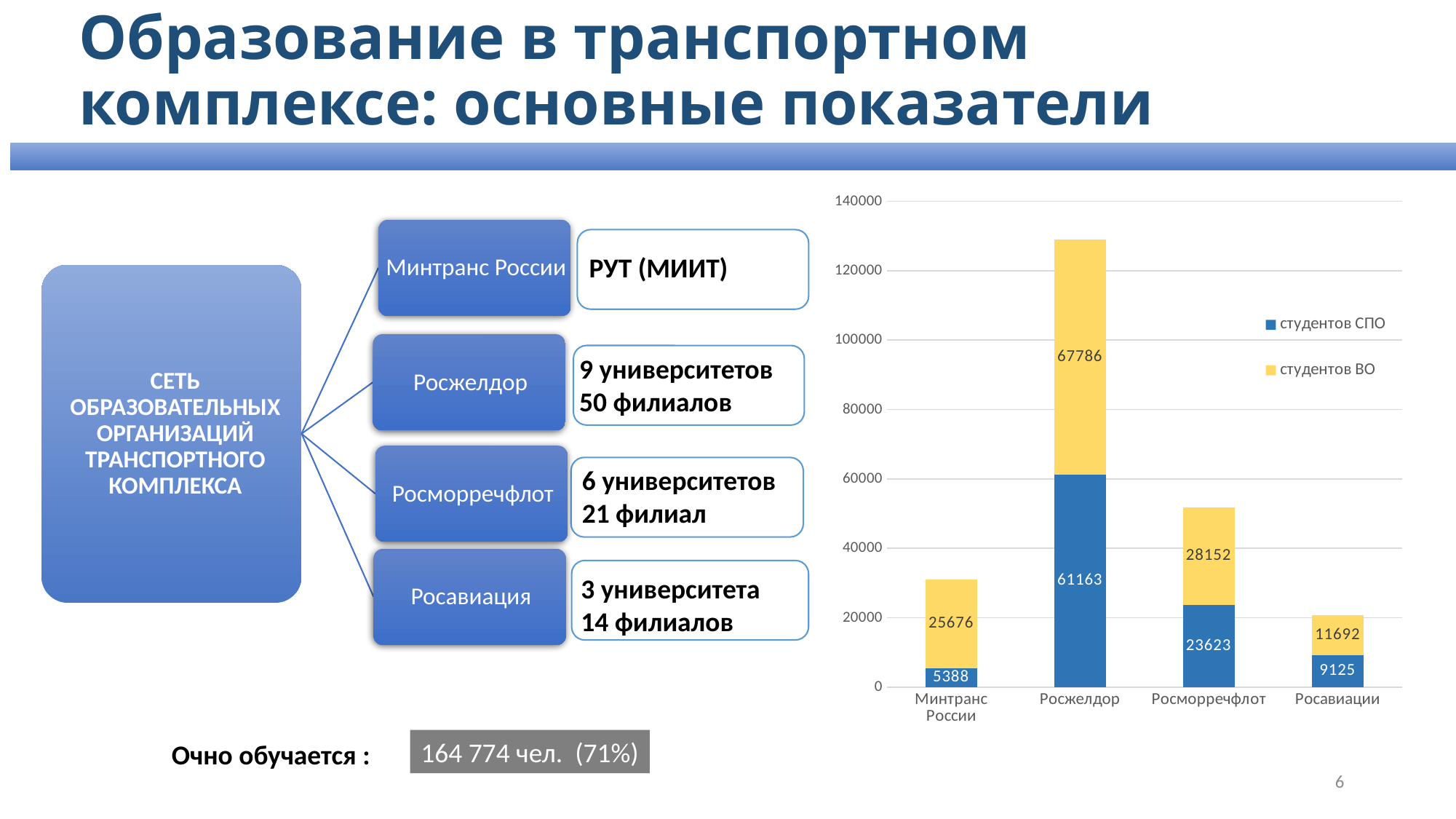
How many series does the chart legend list? 2 What is the total height of the stacked bar for Росавиации? 20817 What is the value of студентов ВО for Минтранс России? 25676 What is the value of студентов СПО for Росжелдор? 61163 Which category has the lowest value of студентов СПО? Минтранс России Which is larger: студентов СПО for Росморречфлот or студентов ВО for Росавиации? студентов СПО for Росморречфлот What is the value of студентов СПО for Росавиации? 9125 What kind of chart is shown on the slide? stacked bar chart What is the difference between студентов ВО and студентов СПО for Росморречфлот? 4529 Which category has the highest value of студентов ВО? Росжелдор How many categories are shown on the x axis of the chart? 4 Is the total stacked bar for Росжелдор greater or less than 120000? greater